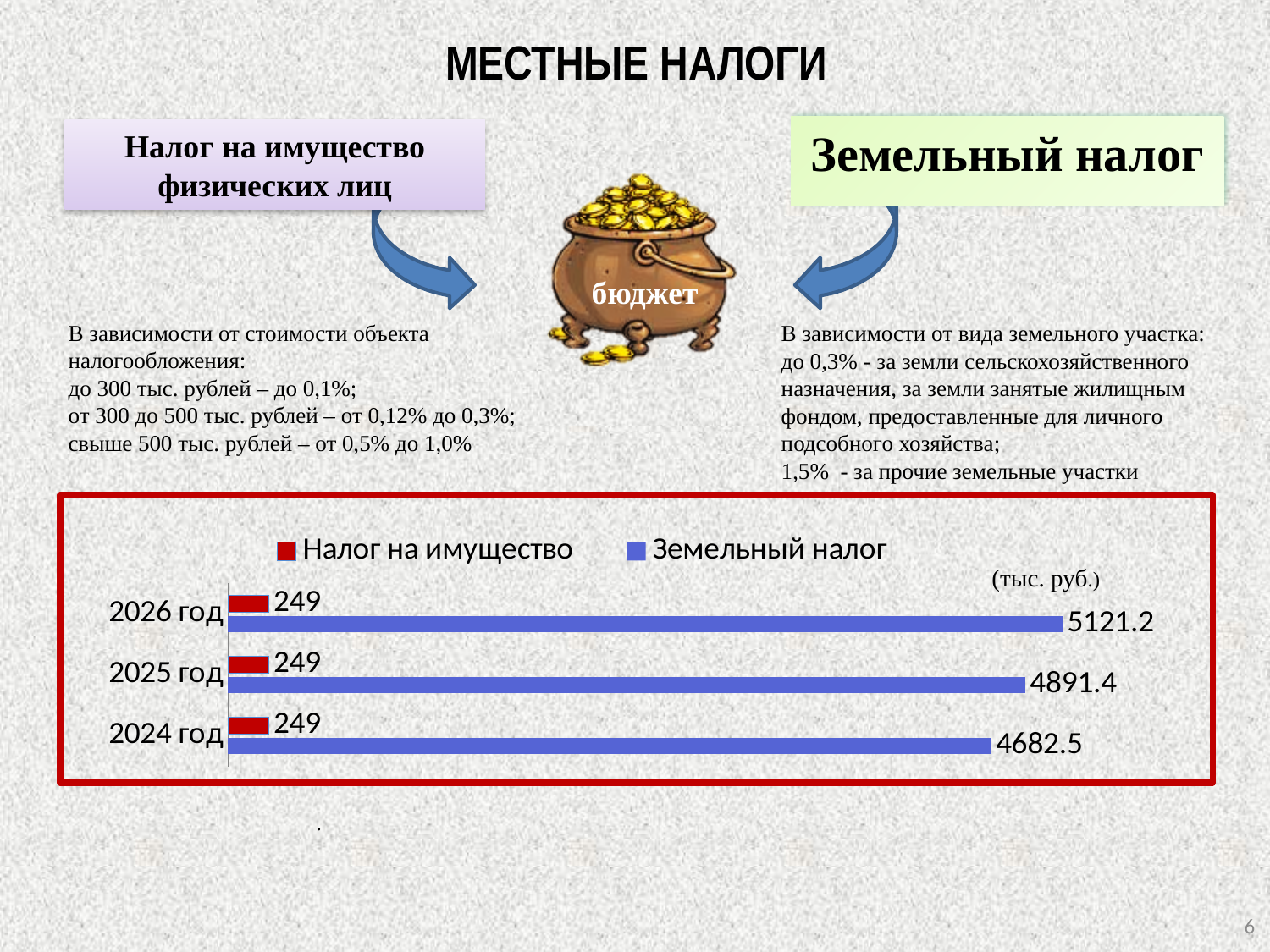
What is the difference between the Земельный налог values for 2026 год and 2025 год? 229.8 Does the value of Земельный налог rise or fall from 2024 год to 2026 год? rise Which year has the highest value for Земельный налог? 2026 год How many years are shown in the chart? 3 Which year has the lowest value for Земельный налог? 2024 год What is the value of Налог на имущество for 2025 год? 249 How many series does the legend list? 2 Which is larger for 2024 год: Налог на имущество or Земельный налог? Земельный налог What is the value of Земельный налог for 2024 год? 4682.5 What is the value of Земельный налог for 2026 год? 5121.2 What is the difference between the Земельный налог values for 2025 год and 2024 год? 208.9 What kind of chart is shown on the slide? bar chart